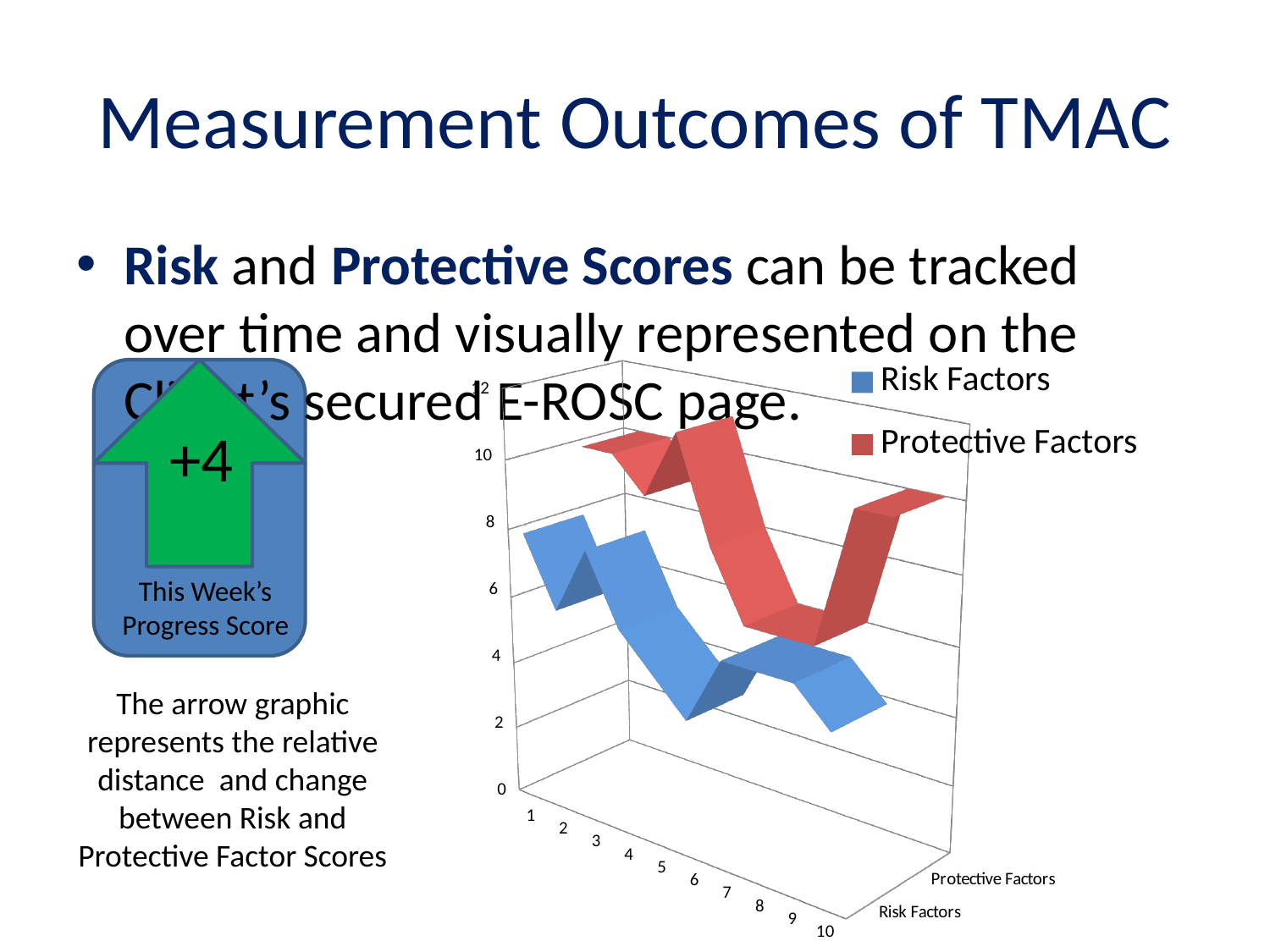
Is the Protective Factors value at point 1 greater or less than 8? greater What kind of chart is shown on the slide? 3D line chart Which colour represents Protective Factors in the chart? red Do the Protective Factors values rise or fall from point 1 to point 6? fall How many points are plotted along the x axis for each series? 10 Do the Risk Factors values generally rise or fall from point 1 to point 10? fall What are the two series named in the chart's legend? Risk Factors and Protective Factors At point 10, which series has the higher value, Risk Factors or Protective Factors? Protective Factors How many series does the chart's legend list? 2 At point 1, which series has the higher value, Risk Factors or Protective Factors? Protective Factors What is the highest value shown on the chart's vertical axis? 12 Is the Risk Factors value at point 10 greater or less than 6? less